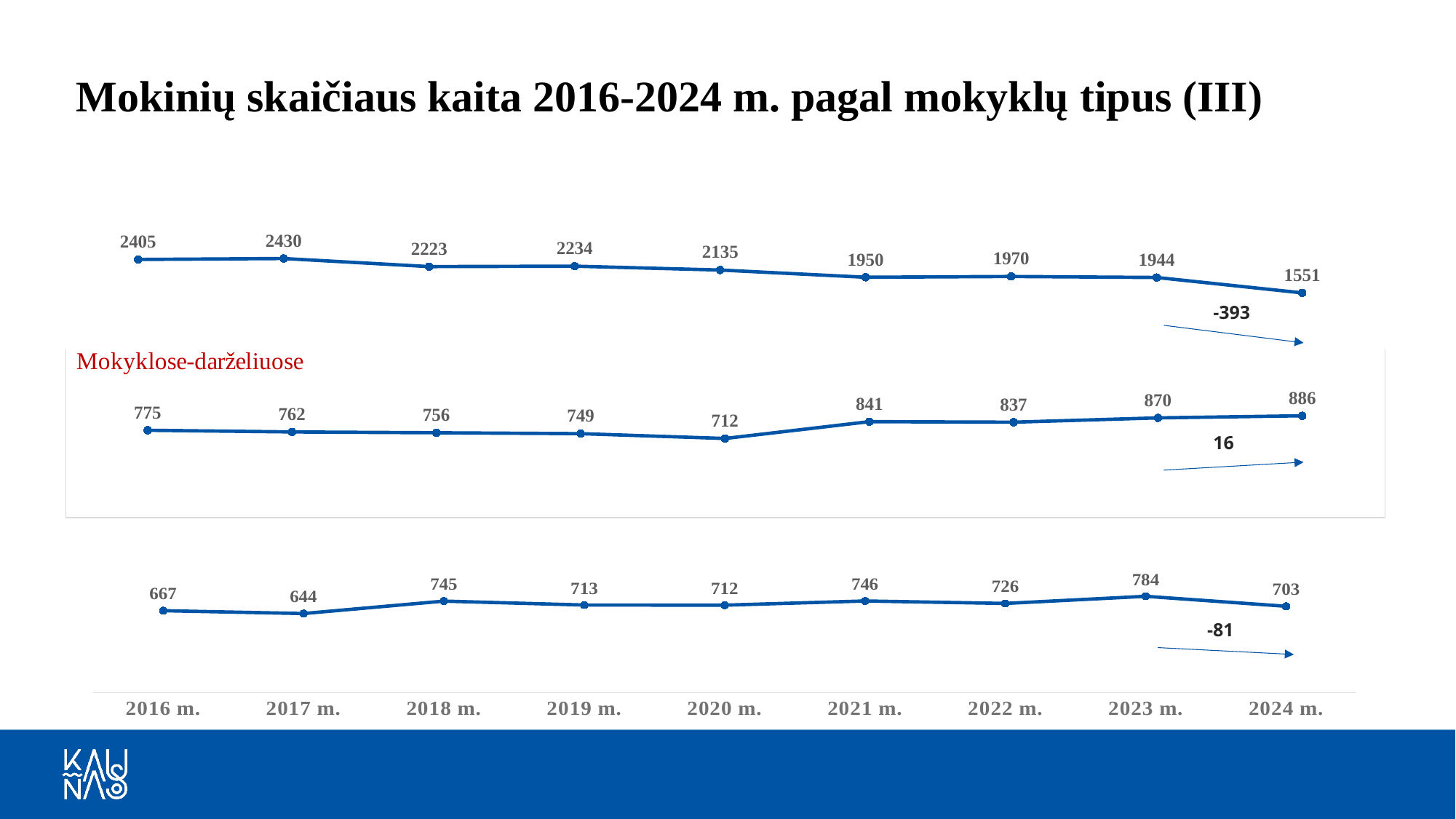
In the bottom chart on the slide, what is the value for 2023 m.? 784 In the middle chart (Mokyklose-darželiuose), which year has the lowest value? 2020 m. In the top chart on the slide, what is the difference between the 2023 m. and 2024 m. values? 393 In the top chart on the slide, which year has the lowest value? 2024 m. In the middle chart (Mokyklose-darželiuose), what is the value for 2020 m.? 712 In the top chart on the slide, which year has the highest value? 2017 m. In the bottom chart on the slide, what is the difference between the 2018 m. and 2017 m. values? 101 In the middle chart (Mokyklose-darželiuose), which year has the highest value? 2024 m. How many years are plotted along the x axis of the charts on the slide? 9 In the bottom chart on the slide, which year has the lowest value? 2017 m. In the middle chart (Mokyklose-darželiuose), is the value for 2021 m. larger or smaller than the value for 2019 m.? larger In the top chart on the slide, what is the value for 2016 m.? 2405